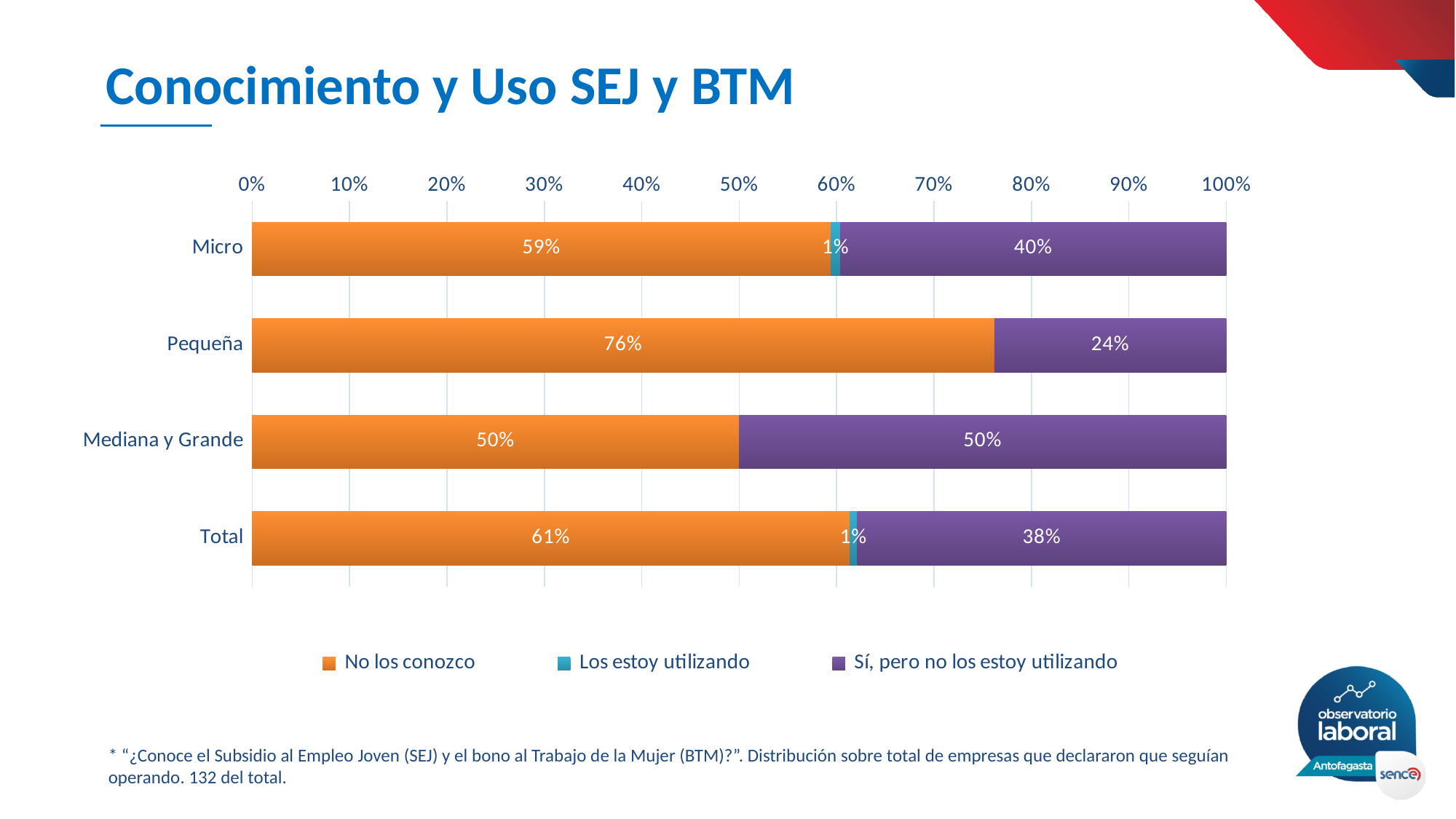
What is the value of "Sí, pero no los estoy utilizando" for Pequeña? 24% Which colour represents "Los estoy utilizando" in the legend? Teal/light blue What is the value of "No los conozco" for Micro? 59% What is the value of "Sí, pero no los estoy utilizando" for Mediana y Grande? 50% Which is larger: "Sí, pero no los estoy utilizando" for Micro or for Total? Micro Which category has the highest value for "No los conozco"? Pequeña What is the difference between the "No los conozco" values for Pequeña and Micro? 17% What is the value of "Los estoy utilizando" for Total? 1% What kind of chart is shown on the slide? Stacked bar chart How many categories are shown on the vertical axis? 4 How many series does the legend list? 3 Which category has the lowest value for "No los conozco"? Mediana y Grande